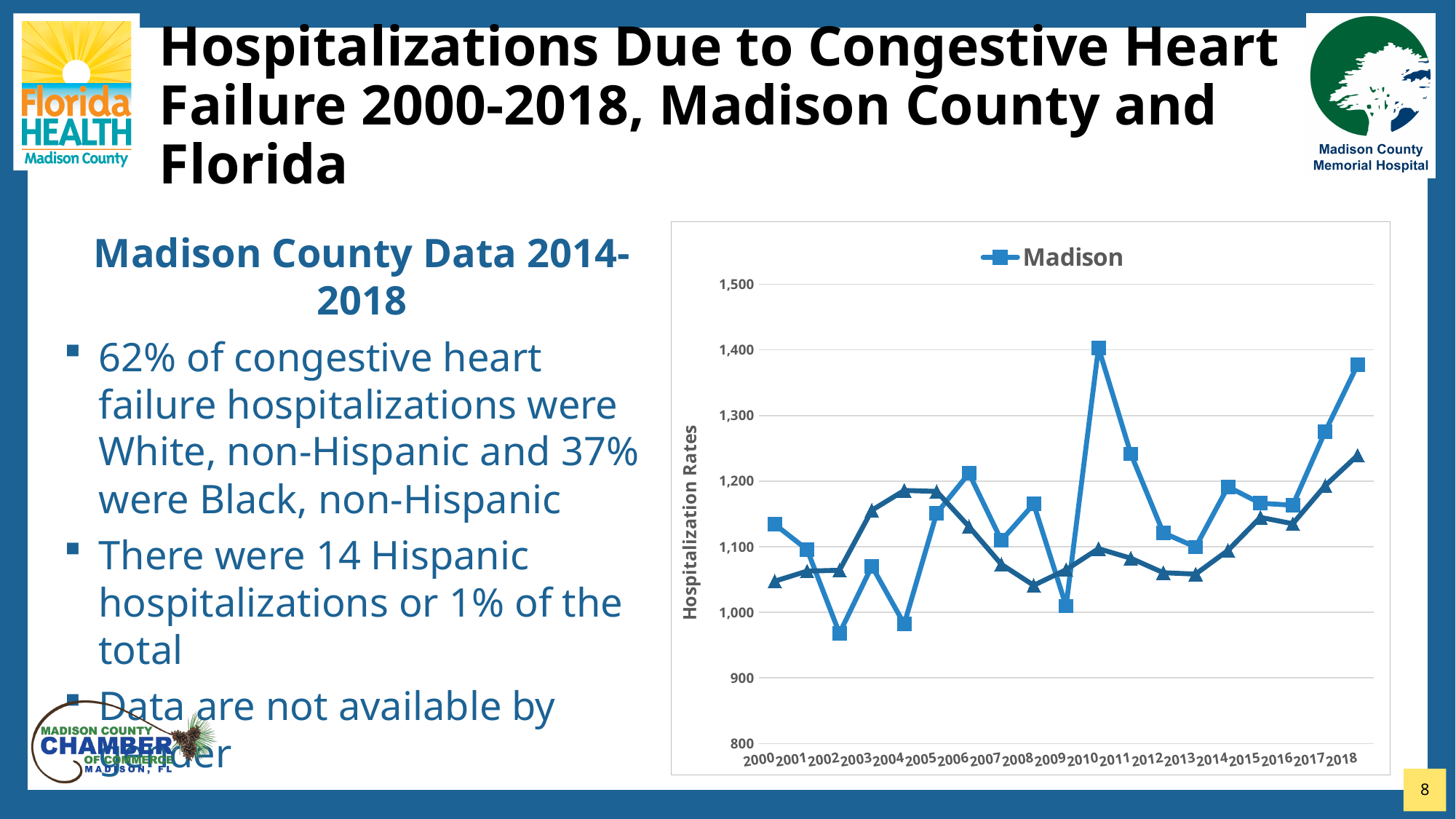
Is the Madison value for 2002 greater or less than 1,000? less Which year has the larger Madison value, 2009 or 2010? 2010 Is the Madison value for 2010 greater or less than 1,300? greater Is the Madison value for 2009 greater or less than 1,100? less What series name appears in the chart's legend? Madison What kind of chart is shown on the slide? Line chart How many series does the chart's legend list? 1 Do the Madison values rise or fall from 2010 to 2013? fall How many years are plotted along the x axis of the chart? 19 What is the title of the vertical axis of the chart? Hospitalization Rates